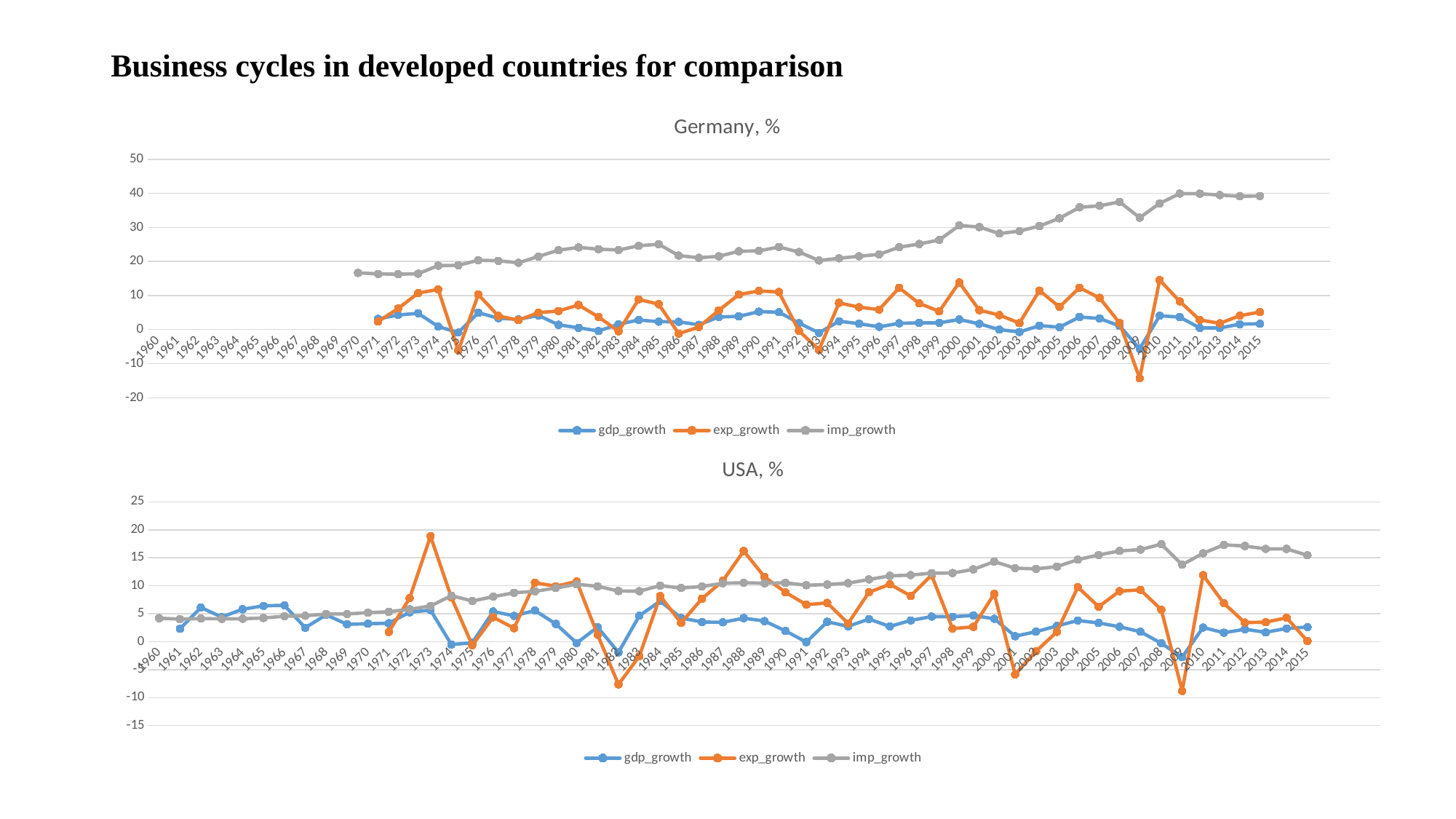
In the "USA, %" chart, which is larger in 1973: exp_growth or gdp_growth? exp_growth In the "Germany, %" chart, does imp_growth generally rise or fall from 1970 to 2015? rise In the "USA, %" chart, is the imp_growth value for 2015 greater or less than 10? greater What is the title of the lower chart on the slide? USA, % In the "Germany, %" chart, which series is plotted in grey? imp_growth In the "Germany, %" chart, in which year is exp_growth at its lowest? 2009 In the "USA, %" chart, in which year is exp_growth at its lowest? 2009 How many series does the legend of the "USA, %" chart list? 3 In the "USA, %" chart, in which year does exp_growth reach its highest value? 1973 In the "Germany, %" chart, is the imp_growth value for 2015 greater or less than 30? greater What kind of chart is the "Germany, %" chart? line chart In the "Germany, %" chart, is the exp_growth value for 2009 greater or less than -10? less